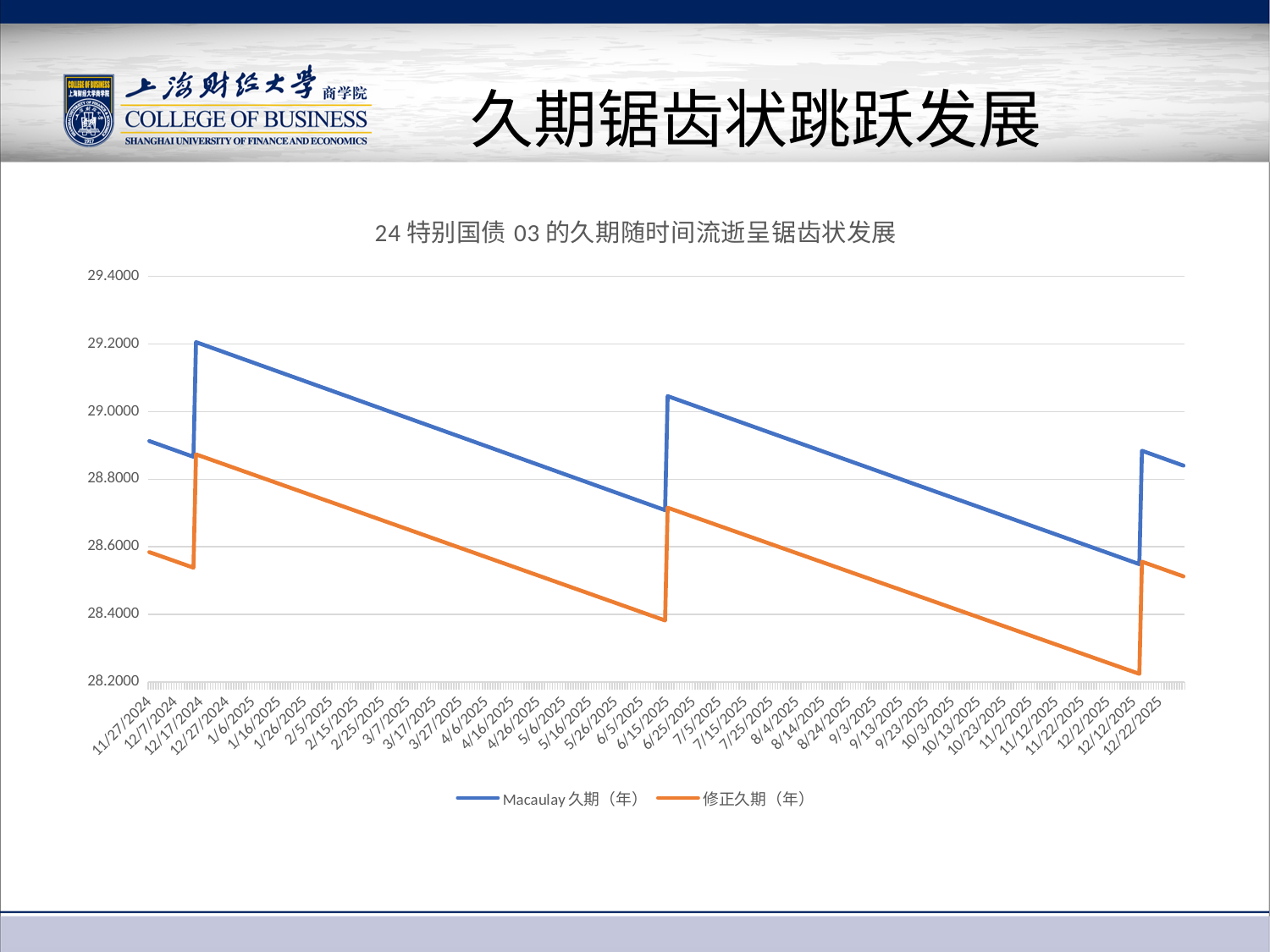
What is the title of the chart? 24 特别国债 03 的久期随时间流逝呈锯齿状发展 Is the Macaulay 久期（年） value at 11/27/2024 greater or less than 28.8? greater What kind of chart is shown on the slide? Line chart Is the highest value reached by the 修正久期（年） line greater or less than 28.8? greater What is the highest value shown on the vertical axis? 29.4000 Is the highest value reached by the Macaulay 久期（年） line greater or less than 29.0? greater Between the jump in December 2024 and the jump in June 2025, does the Macaulay 久期（年） line rise or fall? Fall How many series does the chart's legend list? 2 Which series is drawn in orange? 修正久期（年） At 6/5/2025, which series has the higher value, Macaulay 久期（年） or 修正久期（年）? Macaulay 久期（年）